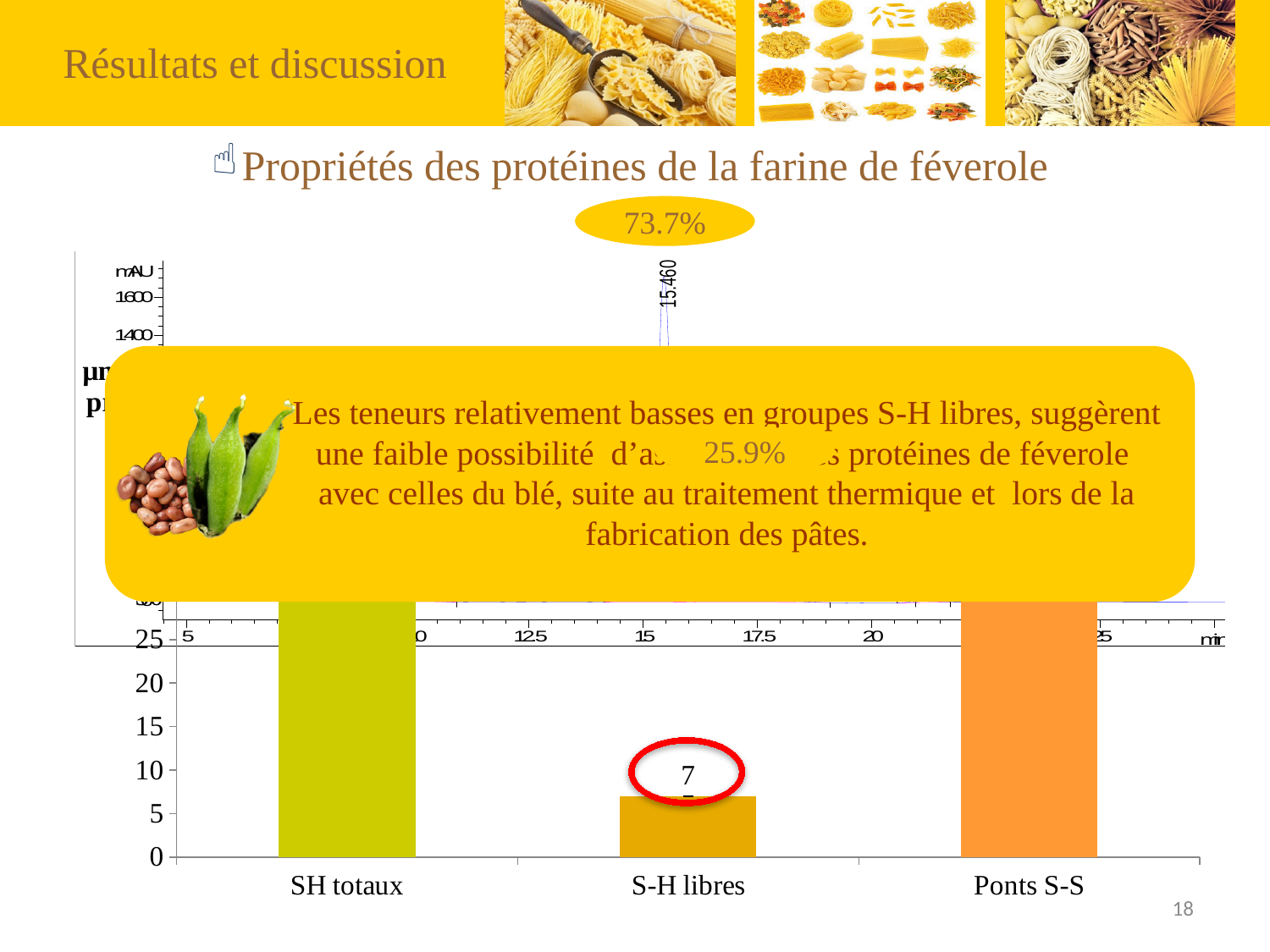
Which is larger, the bar for Ponts S-S or the bar for S-H libres? Ponts S-S Is the value for Ponts S-S greater or less than 25? greater Which is larger, the bar for SH totaux or the bar for S-H libres? SH totaux What is the value shown for S-H libres in the bar chart? 7 Is the value for S-H libres greater or less than 10? less What colour is the bar for Ponts S-S? orange Is the value for SH totaux greater or less than 25? greater In the chromatogram in the background, what retention time is labelled on the tallest peak? 15.460 How many categories are shown on the x axis of the bar chart? 3 What is the highest tick value shown on the y axis of the bar chart? 25 Which category has the lowest bar in the bar chart? S-H libres What kind of chart is the chart at the bottom of the slide? bar chart